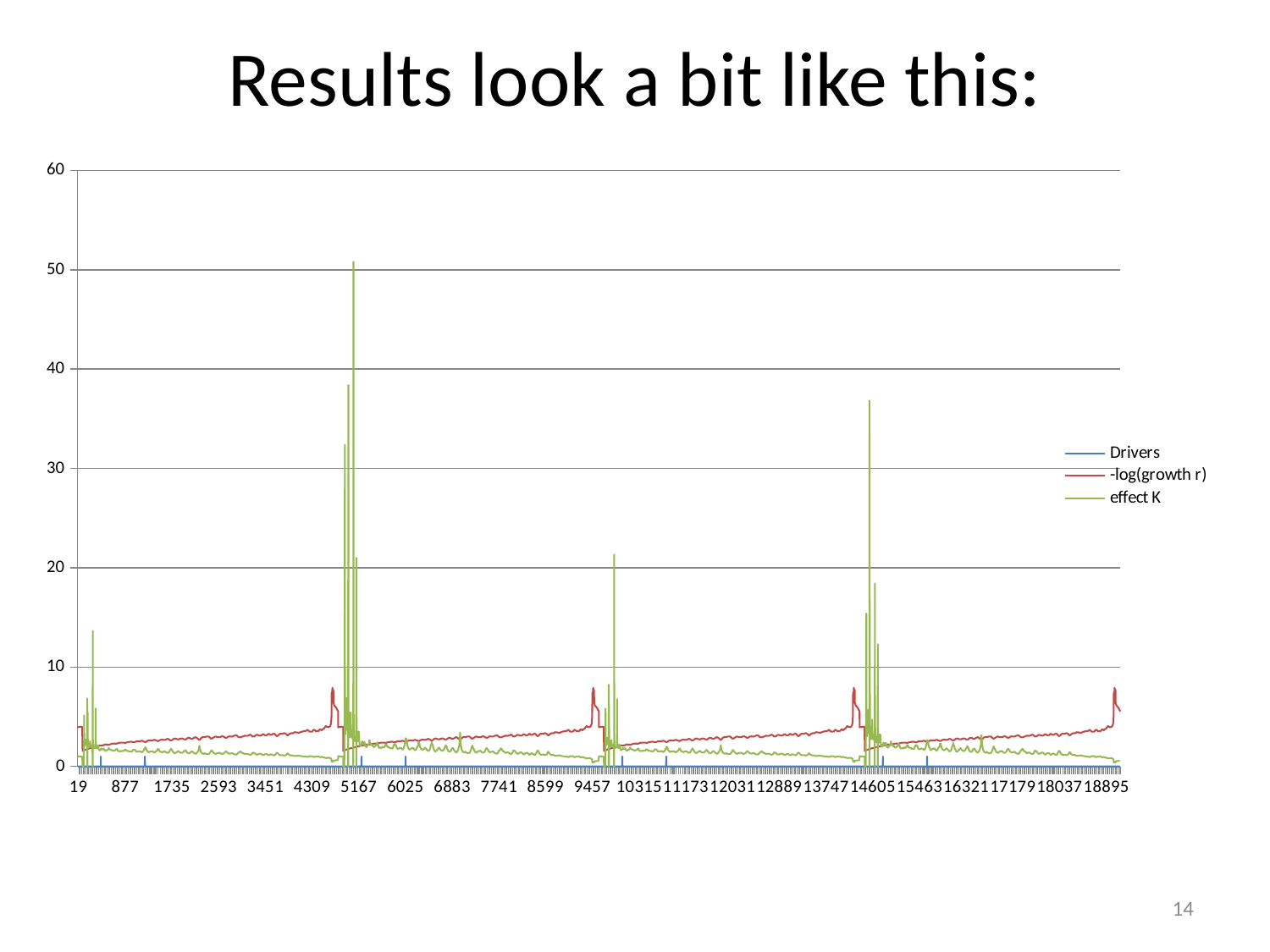
Which series reaches the highest value on the chart? effect K Which series stays lowest across the chart? Drivers What are the three series named in the legend? Drivers, -log(growth r), effect K What colour is the line for the effect K series? green Is the Drivers series greater or less than 10 across the whole chart? less Is the highest value of the -log(growth r) series greater or less than 10? less Which series has the taller spikes, effect K or -log(growth r)? effect K What kind of chart is shown on the slide? line chart What is the highest value shown on the y axis? 60 Between its sharp spikes, does the -log(growth r) line rise or fall along the x axis? rise Is the highest peak of the effect K series greater or less than 40? greater How many series does the legend list? 3